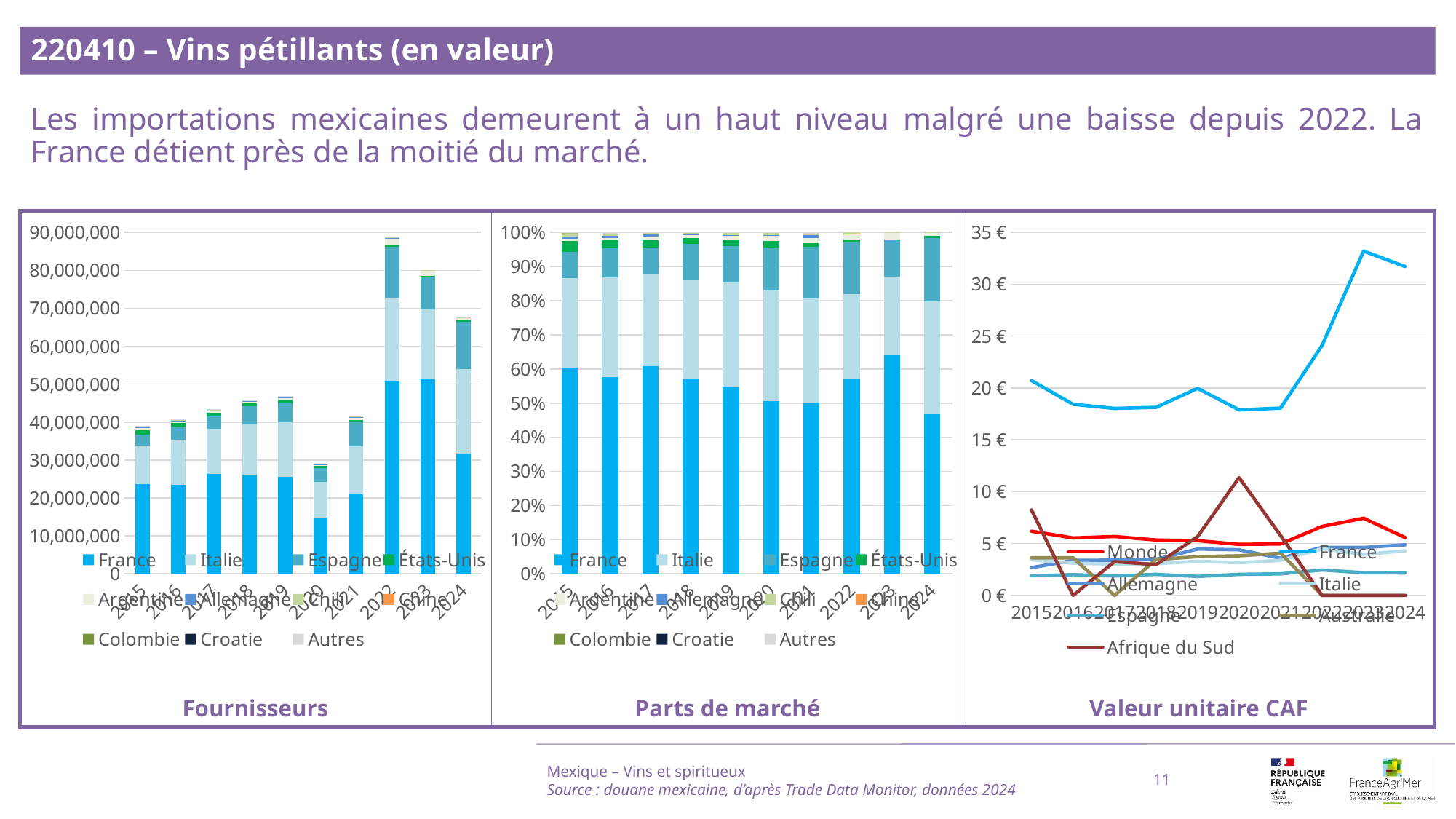
How many series does the legend of the 'Valeur unitaire CAF' chart list? 7 In the 'Fournisseurs' chart, which year has the tallest total bar? 2022 In the 'Parts de marché' chart, is the France share for 2024 greater or less than 50%? less What kind of chart is the 'Valeur unitaire CAF' chart? Line chart In the 'Fournisseurs' chart, which year has the shortest total bar? 2020 How many years are plotted on the x axis of the 'Parts de marché' chart? 10 In the 'Valeur unitaire CAF' chart, is the Afrique du Sud value for 2020 greater or less than 10 €? greater What kind of chart is the 'Fournisseurs' chart? Stacked bar chart In the 'Parts de marché' chart, which year shows the largest share for France? 2023 In the 'Fournisseurs' chart, is the France segment for 2020 greater or less than 20,000,000? less How many series does the legend of the 'Fournisseurs' chart list? 11